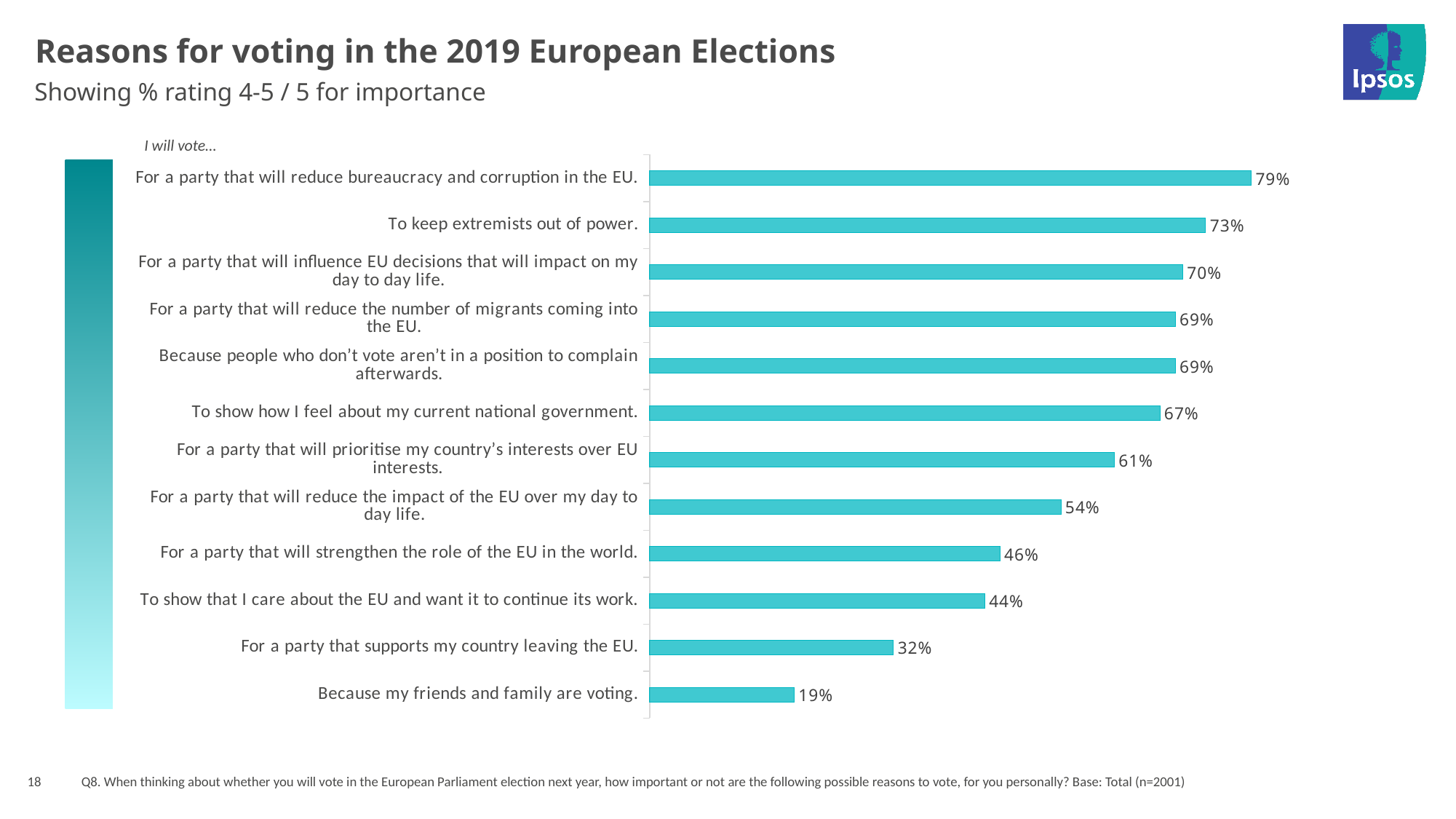
What is the difference between 'For a party that will strengthen the role of the EU in the world' and 'To show that I care about the EU and want it to continue its work'? 2 percentage points Which reason for voting has the lowest percentage? Because my friends and family are voting. What is the value for 'To show how I feel about my current national government'? 67% What is the title of the chart on the slide? Reasons for voting in the 2019 European Elections What is the base size (n) stated in the footnote of the slide? n=2001 What is the value for 'For a party that supports my country leaving the EU'? 32% Which reason for voting has the highest percentage? For a party that will reduce bureaucracy and corruption in the EU. What is the difference between the highest value (79%) and the lowest value (19%)? 60 percentage points What percentage rated 'To keep extremists out of power' as important (4-5 / 5)? 73% What kind of chart is shown on the slide? Bar chart Which is larger: the value for 'For a party that will prioritise my country's interests over EU interests' or 'For a party that will reduce the impact of the EU over my day to day life'? For a party that will prioritise my country's interests over EU interests How many reasons for voting are shown in the chart? 12